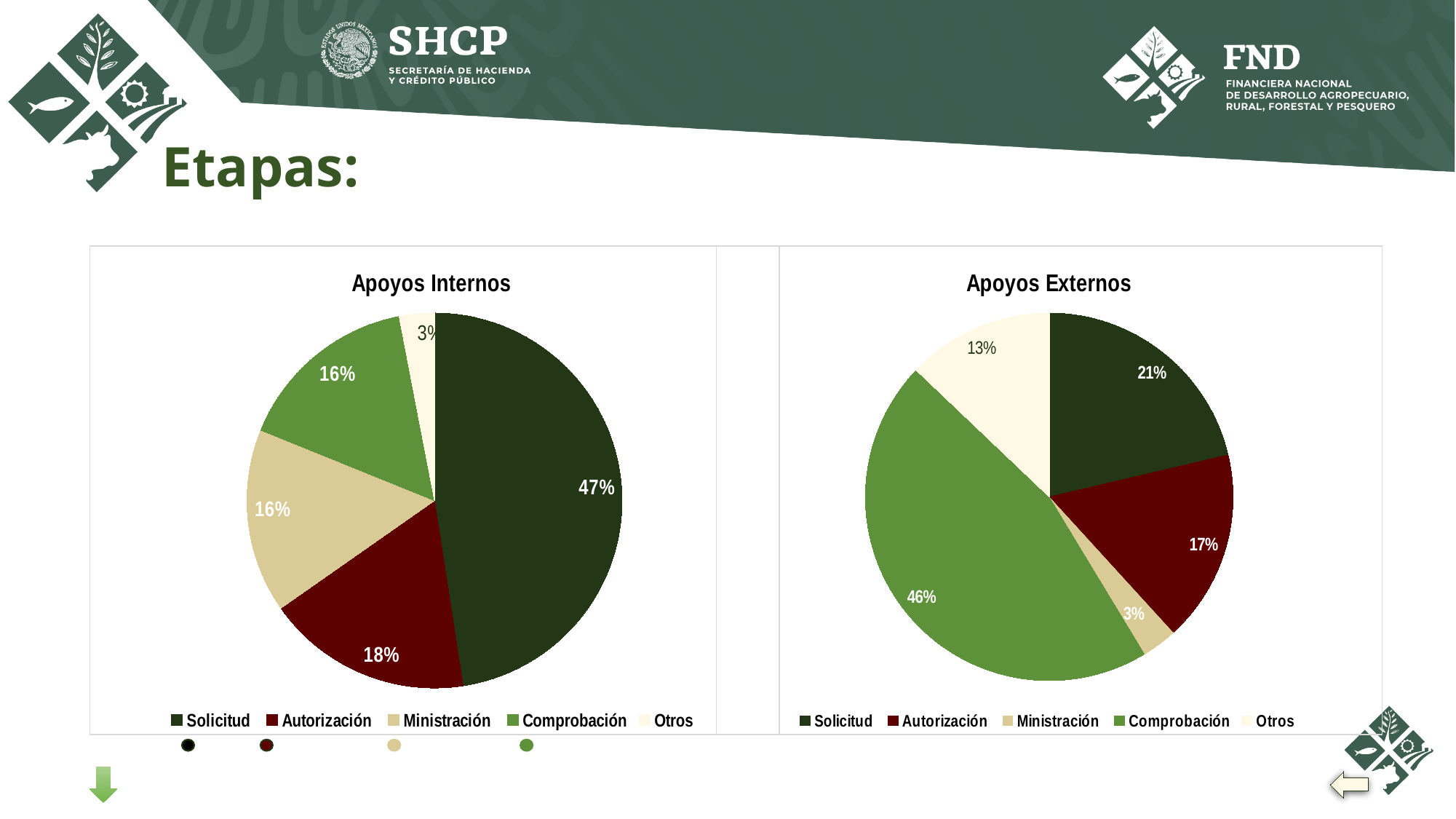
In the Apoyos Internos chart, which category has the largest slice? Solicitud In the Apoyos Internos chart, what share does Solicitud have? 47% In the Apoyos Internos chart, what is the difference between the Solicitud and Autorización shares? 29% How many categories does the legend of the Apoyos Internos chart list? 5 In the Apoyos Externos chart, which is larger, Solicitud or Autorización? Solicitud What kind of chart is the Apoyos Externos chart? Pie chart In the Apoyos Externos chart, what share does Comprobación have? 46% In the Apoyos Externos chart, what is the difference between the Comprobación and Solicitud shares? 25% In the Apoyos Externos chart, what share does Otros have? 13% In the Apoyos Internos chart, which category has the smallest slice? Otros In the Apoyos Externos chart, which category has the smallest slice? Ministración